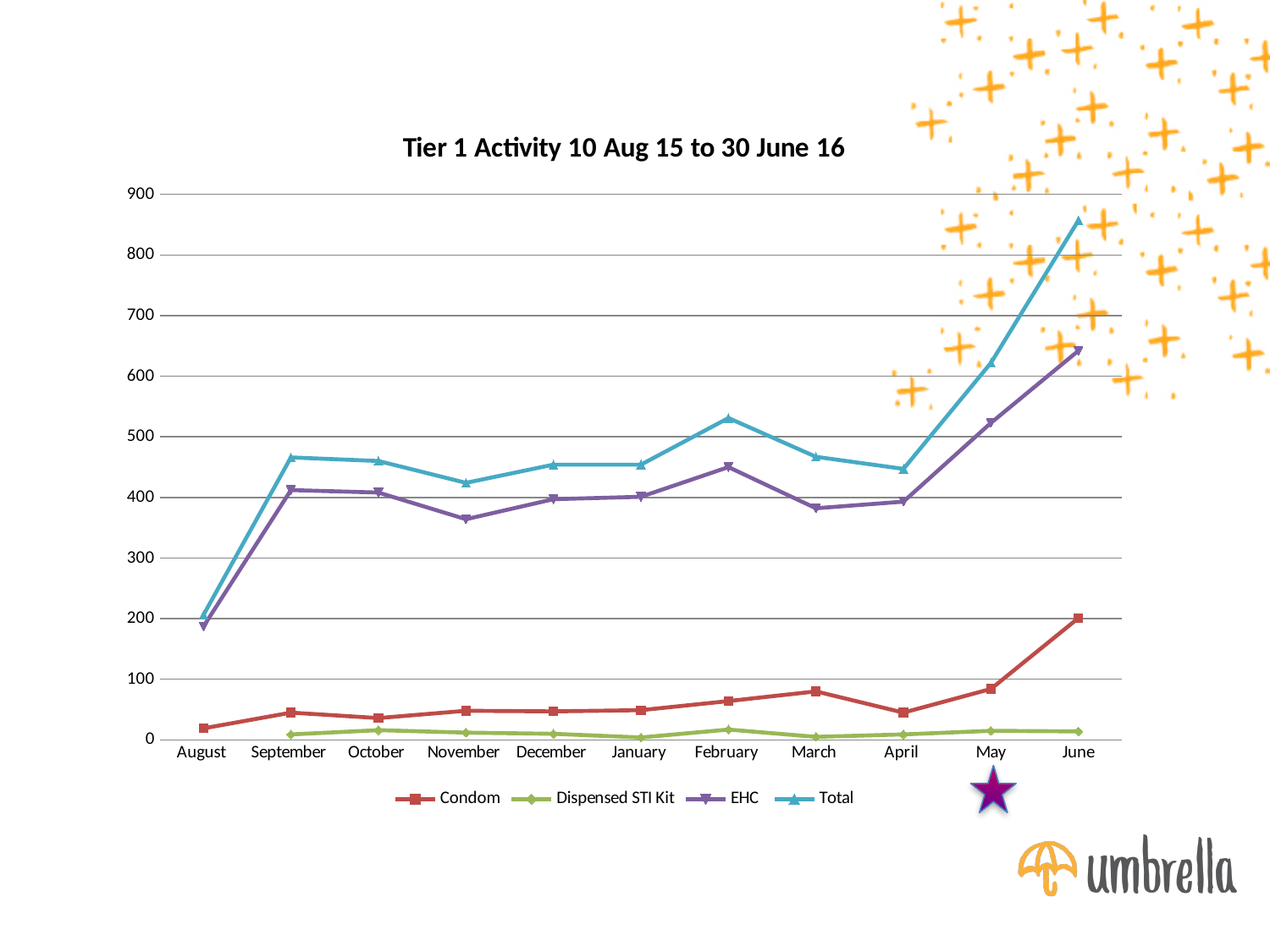
How many series does the legend list? 4 How many months are plotted along the x axis? 11 Is the value for Total in June greater or less than 800? greater Is the value for Condom in March greater or less than 100? less What kind of chart is shown on the slide? line chart In which month is the Condom series highest? June Is the value for EHC in June greater or less than 600? greater In which month is the EHC series lowest? August What is the title of the chart? Tier 1 Activity 10 Aug 15 to 30 June 16 In which month is the Total series highest? June In which month is the Total series lowest? August In June, which is larger: Condom or Dispensed STI Kit? Condom